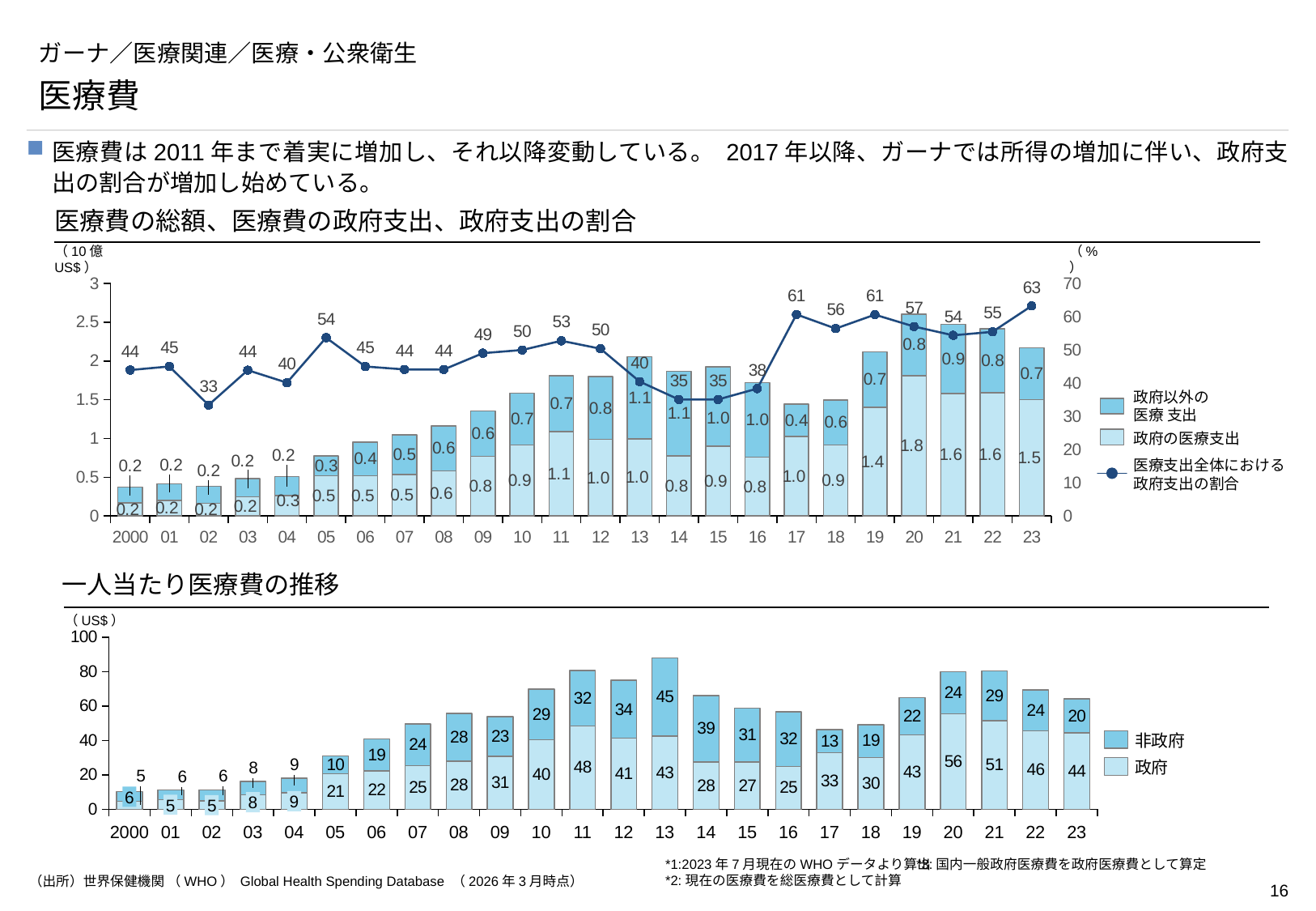
In the bottom chart (一人当たり医療費の推移), what is the value of 政府 for 2020? 56 In the bottom chart, which is larger, 政府 in 2011 or 政府 in 2012? 2011 In the top chart (医療費の総額、医療費の政府支出、政府支出の割合), what is the value of 医療支出全体における政府支出の割合 for 2023? 63 In the bottom chart, how many years are shown on the x axis? 24 In the bottom chart, what is the total of the stacked bar for 2013? 88 In the top chart, how many series does the legend list? 3 What kind of chart is the bottom chart (一人当たり医療費の推移)? Stacked bar chart In the top chart, what is the value of 政府の医療支出 for 2020? 1.8 In the top chart, what is the total of the stacked bar for 2023? 2.2 In the bottom chart, in which year is 非政府 highest? 13 In the top chart, in which year is 医療支出全体における政府支出の割合 lowest? 02 In the top chart, what is the difference between 医療支出全体における政府支出の割合 in 2017 and in 2016? 23